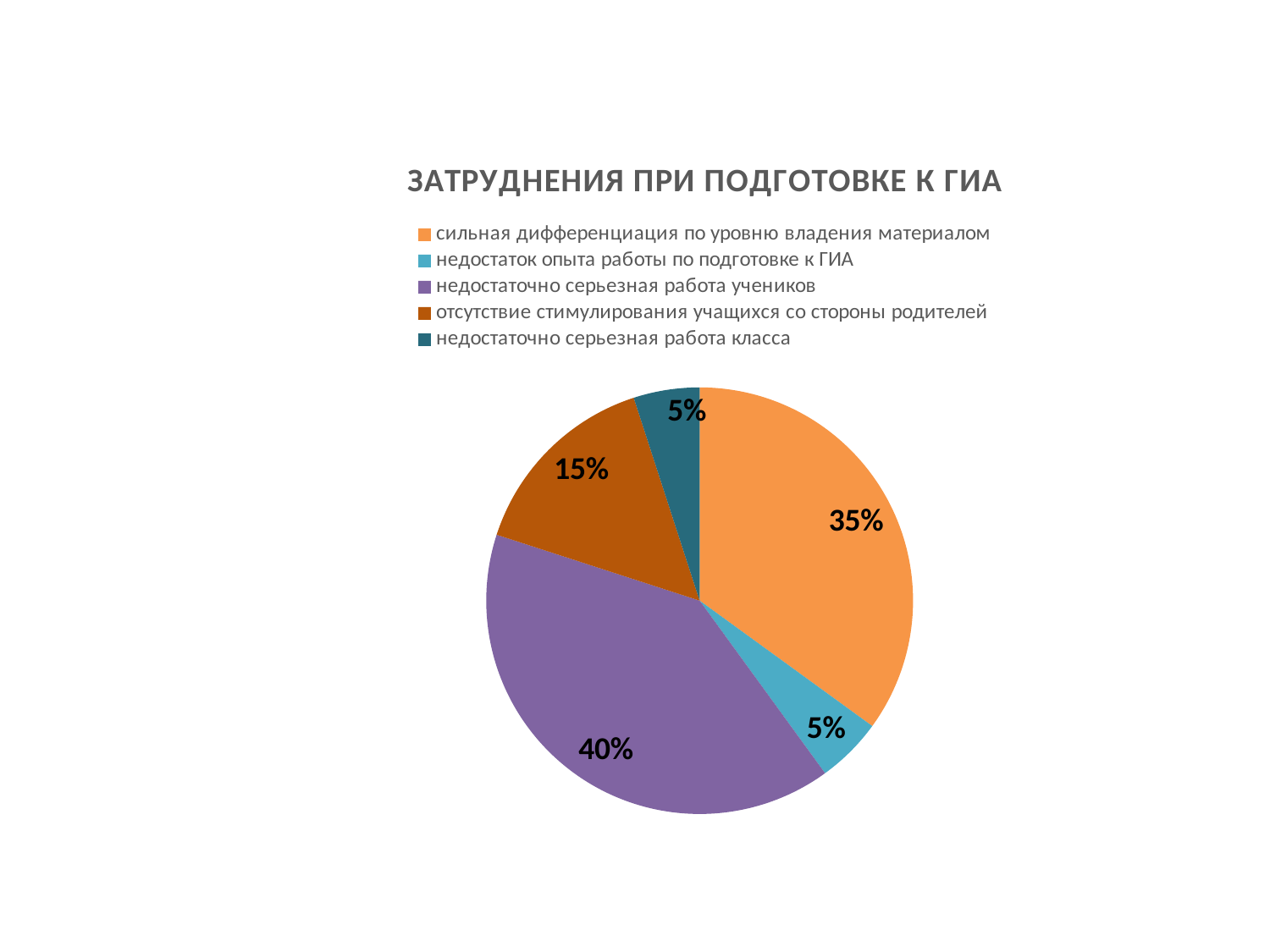
What kind of chart is shown on the slide? pie chart Which is larger: the share for 'отсутствие стимулирования учащихся со стороны родителей' or for 'недостаточно серьезная работа класса'? отсутствие стимулирования учащихся со стороны родителей What share of the pie is 'недостаток опыта работы по подготовке к ГИА'? 5% What is the difference between the shares for 'сильная дифференциация по уровню владения материалом' and 'отсутствие стимулирования учащихся со стороны родителей'? 20% What colour is the slice for 'недостаточно серьезная работа учеников'? purple Which category has the largest slice? недостаточно серьезная работа учеников What is the difference between the shares for 'недостаточно серьезная работа учеников' and 'сильная дифференциация по уровню владения материалом'? 5% How many slices does the pie chart have? 5 What share of the pie is 'сильная дифференциация по уровню владения материалом'? 35% What share of the pie is 'отсутствие стимулирования учащихся со стороны родителей'? 15% What is the title of the chart? ЗАТРУДНЕНИЯ ПРИ ПОДГОТОВКЕ К ГИА